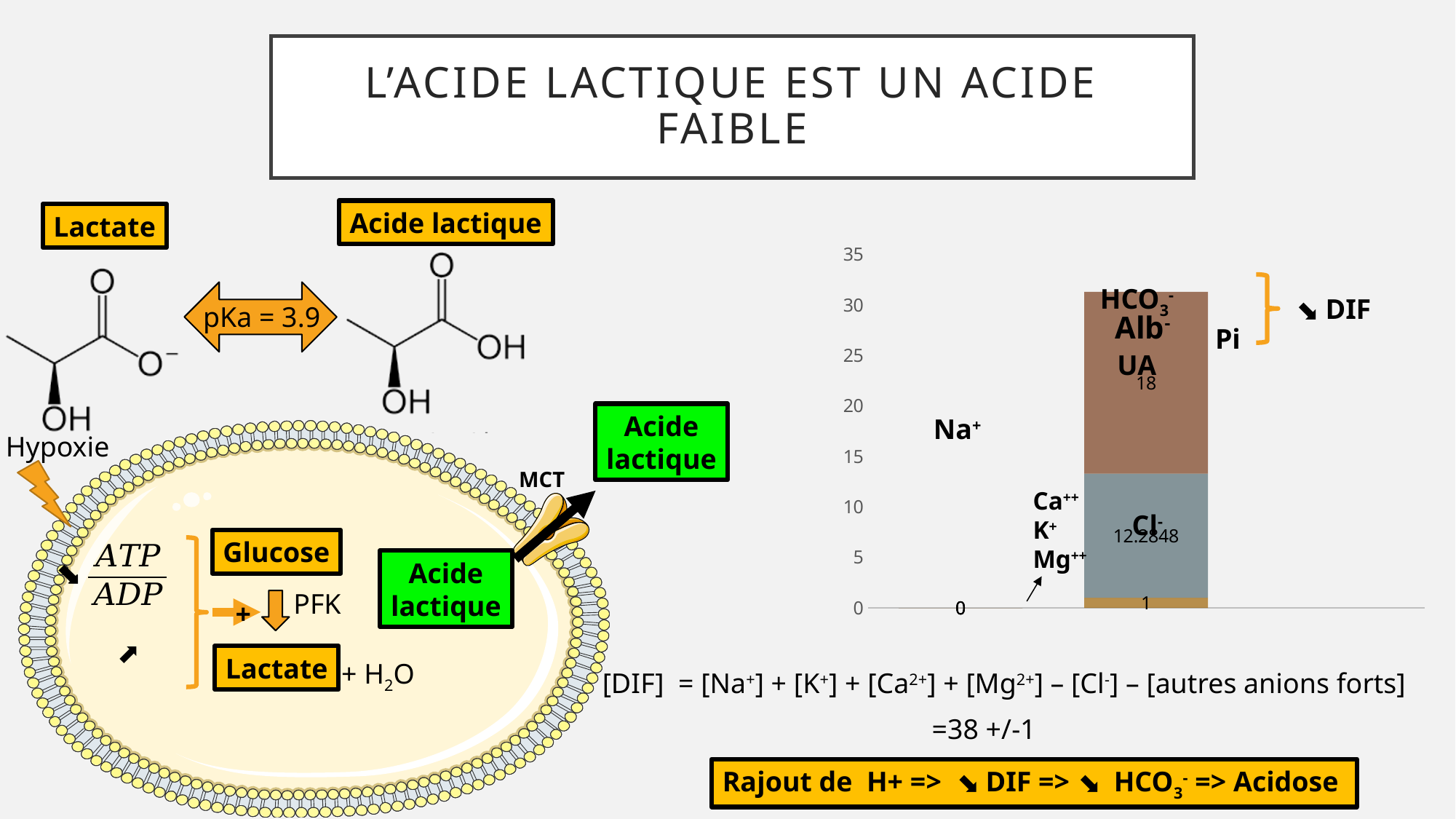
Which segment of the stacked bar has the smallest value? The bottom segment, 1 What is the value of the small bottom segment of the stacked bar? 1 Which is larger, the brown segment or the grey Cl- segment? The brown segment How many segments make up the stacked bar? 3 What is the value of the brown segment labelled HCO3-, Alb-, UA in the stacked bar? 18 What is the highest tick value shown on the y axis of the chart? 35 What is the total of the stacked bar (sum of the segments labelled 1, 12.2848 and 18)? 31.2848 What kind of chart is shown on the right side of the slide? Stacked bar chart What is the difference between the brown segment (18) and the grey Cl- segment (12.2848)? 5.7152 Which segment of the stacked bar has the largest value? The brown segment (HCO3-, Alb-, UA), 18 Is the top of the stacked bar greater or less than 25 on the y axis? greater What is the value of the grey segment labelled Cl- in the stacked bar? 12.2848